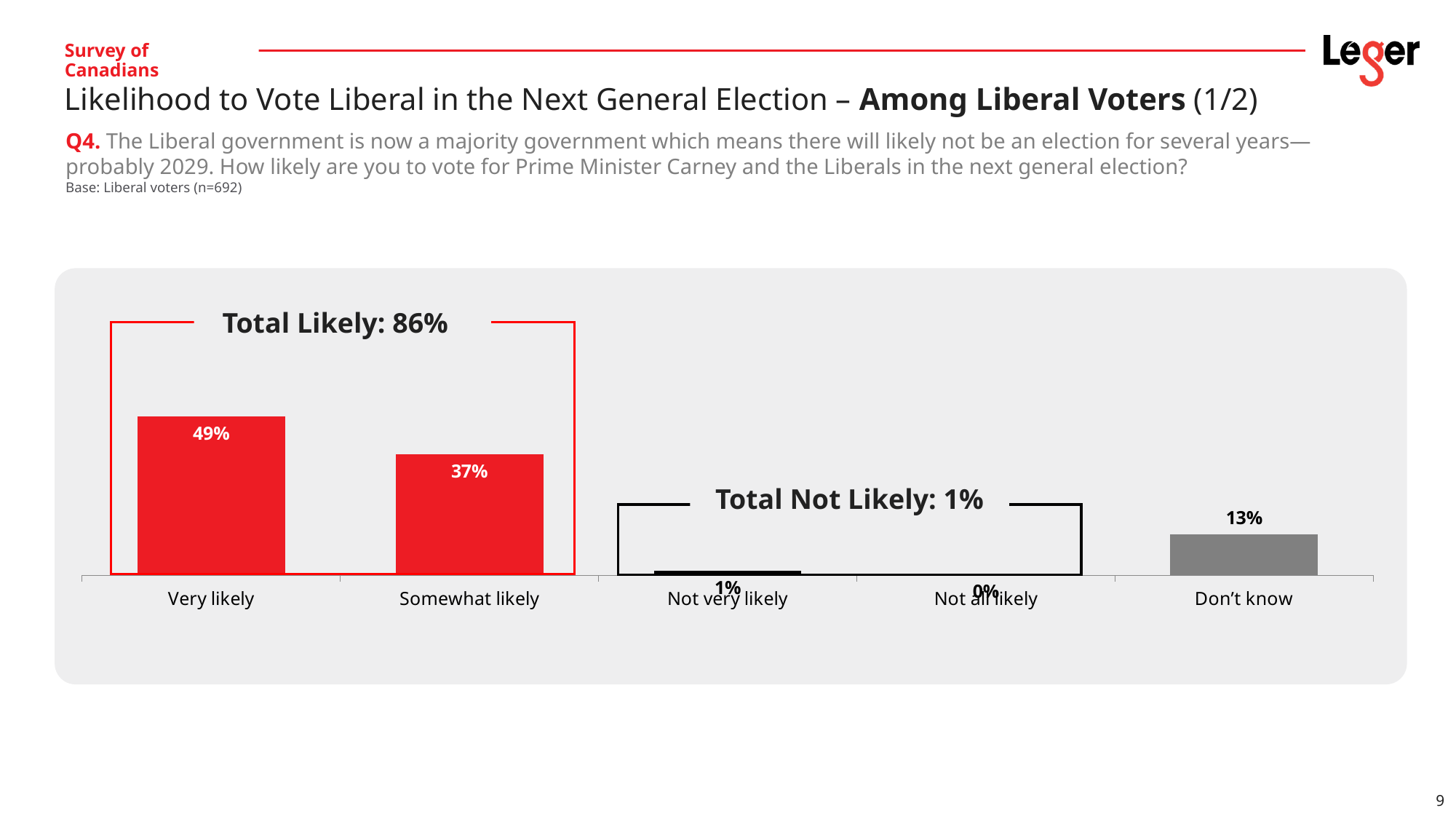
What is the 'Total Not Likely' figure shown on the chart? 1% What is the 'Total Likely' figure shown above the chart? 86% Which is larger, the value for 'Somewhat likely' or the value for 'Don't know'? Somewhat likely What is the difference between the 'Very likely' and 'Somewhat likely' values? 12 percentage points Which response category has the lowest value? Not all likely What is the value shown for 'Not very likely'? 1% What percentage of respondents answered 'Don't know'? 13% What percentage of Liberal voters said they are very likely to vote Liberal in the next general election? 49% What is the value shown for 'Somewhat likely'? 37% What kind of chart is shown on the slide? Bar chart Which response category has the highest value? Very likely How many response categories are shown on the x axis? 5